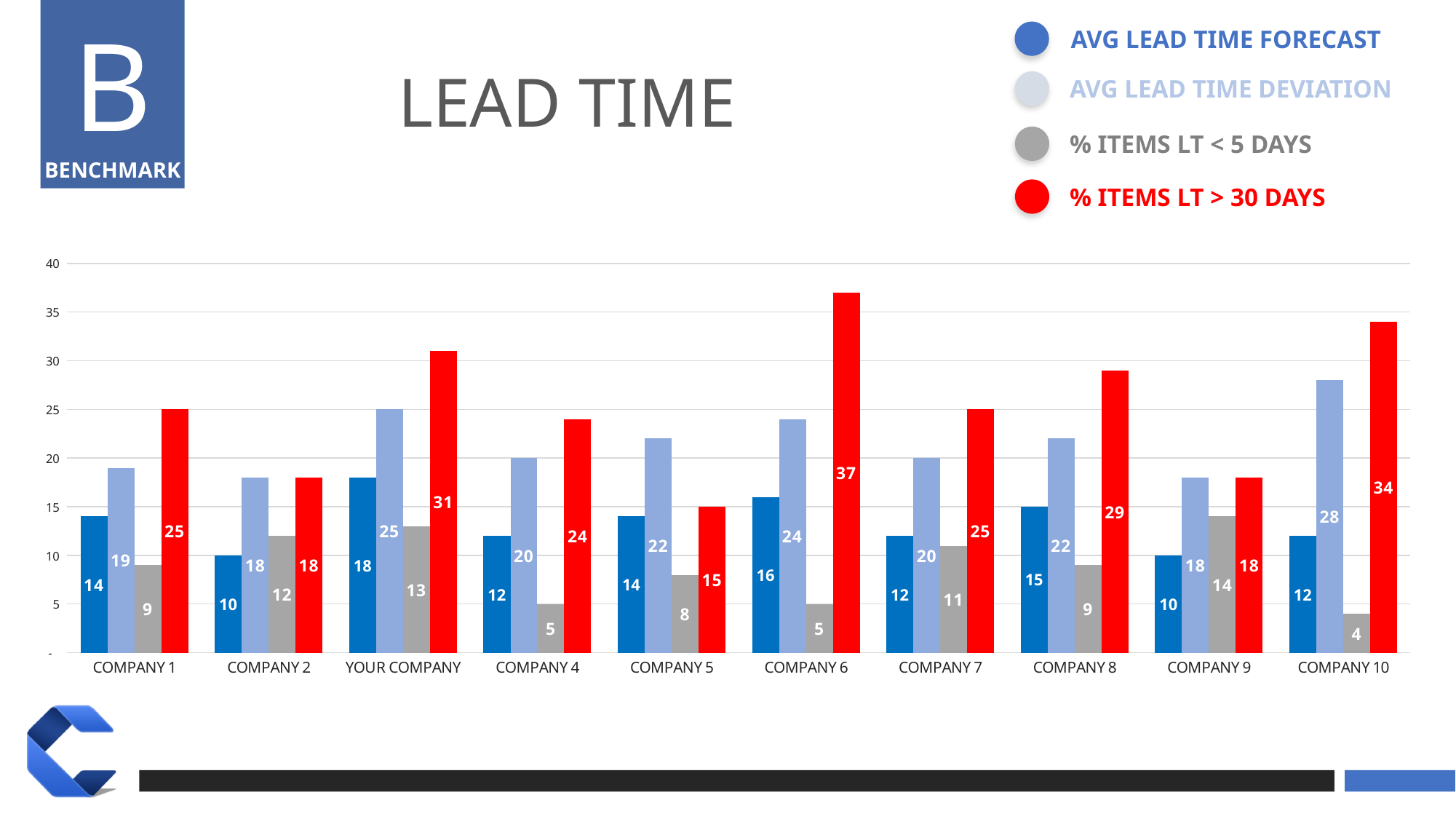
What type of chart is shown on the slide? Bar chart Which is larger: the AVG LEAD TIME DEVIATION for COMPANY 8 or for COMPANY 9? COMPANY 8 Which company has the highest AVG LEAD TIME FORECAST value? YOUR COMPANY How many companies are shown on the x axis? 10 Which company has the highest % ITEMS LT > 30 DAYS value? COMPANY 6 What is the % ITEMS LT > 30 DAYS value for COMPANY 6? 37 What is the AVG LEAD TIME FORECAST value for YOUR COMPANY? 18 What is the % ITEMS LT < 5 DAYS value for COMPANY 9? 14 Which company has the lowest % ITEMS LT < 5 DAYS value? COMPANY 10 How many series does the legend list? 4 What is the AVG LEAD TIME DEVIATION value for COMPANY 10? 28 What is the difference between the % ITEMS LT > 30 DAYS values for COMPANY 6 and COMPANY 5? 22